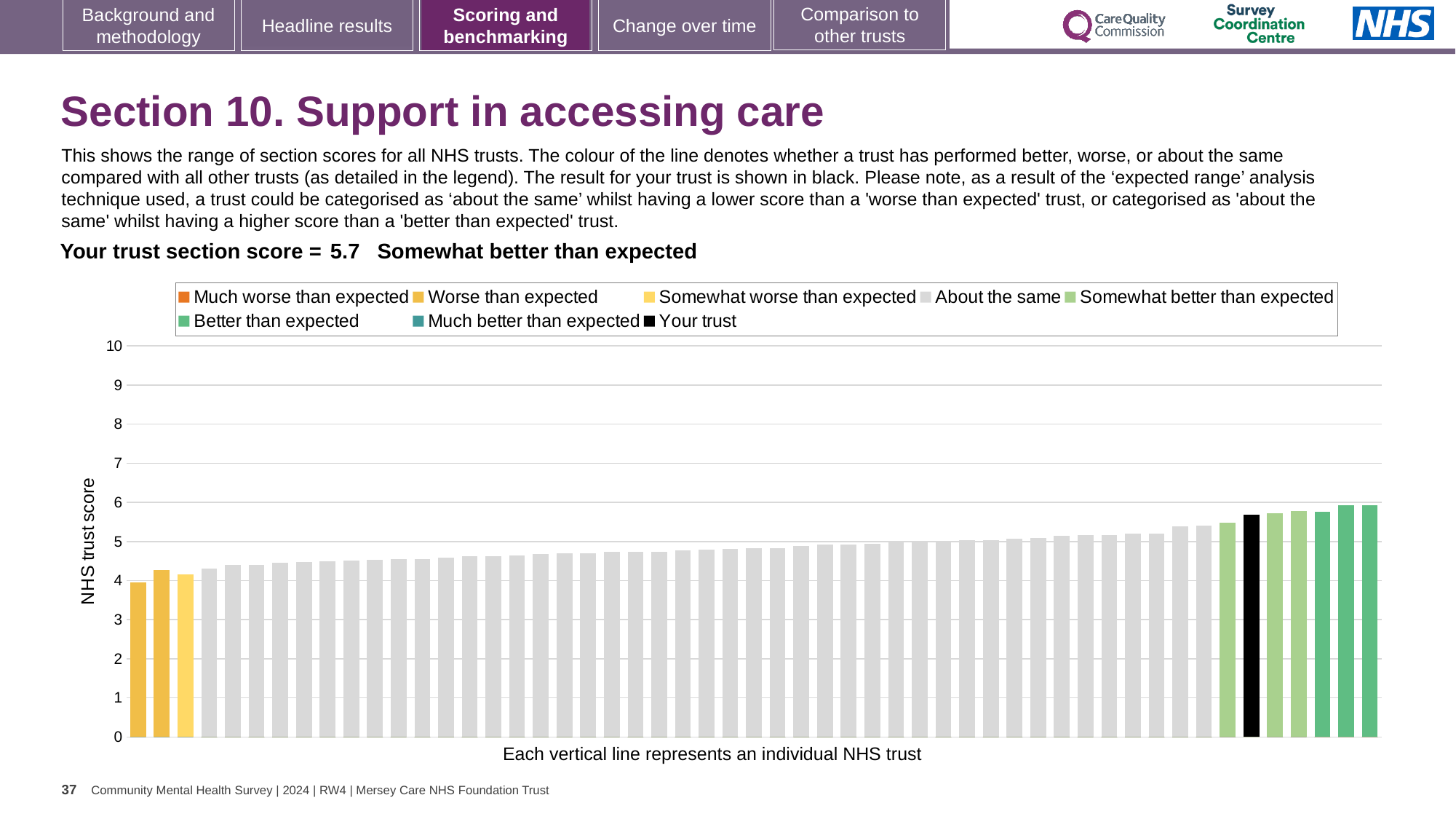
What is the maximum value shown on the vertical axis? 10 What is the section score for your trust shown on the slide? 5.7 What type of chart is shown on the slide? bar chart How many entries does the chart legend list? 8 Is the value for your trust (the black bar) greater or less than 5? greater Is the value for the lowest bar in the chart greater or less than 5? less Do the bar values rise or fall from left to right along the x axis? rise Is the value for the highest bar in the chart greater or less than 7? less How is your trust's section score categorised compared with other trusts? Somewhat better than expected What is the label of the vertical axis? NHS trust score